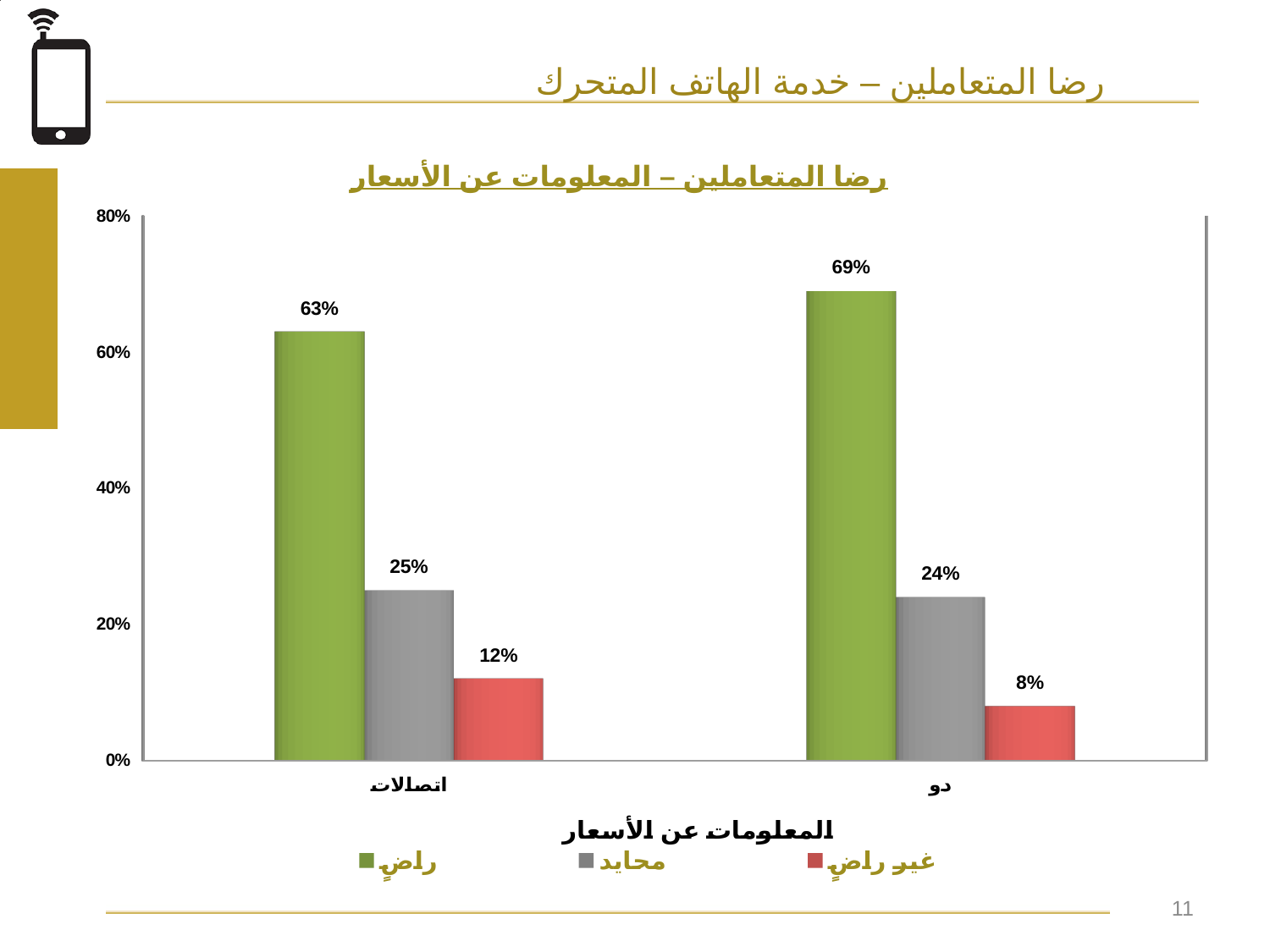
Which category has the higher value for راضٍ, اتصالات or دو? دو What colour represents the غير راضٍ series? red Which series has the lowest value in the اتصالات category? غير راضٍ What kind of chart is shown on the slide? bar chart What is the difference between the غير راضٍ values for اتصالات and دو? 4% How many series does the legend list? 3 What is the value for راضٍ in the اتصالات category? 63% What is the value for محايد in the دو category? 24% What is the difference between the راضٍ values for دو and اتصالات? 6% What is the value for غير راضٍ in the دو category? 8% Is the value for محايد in the اتصالات category greater or less than 20%? greater How many categories are shown on the x axis? 2